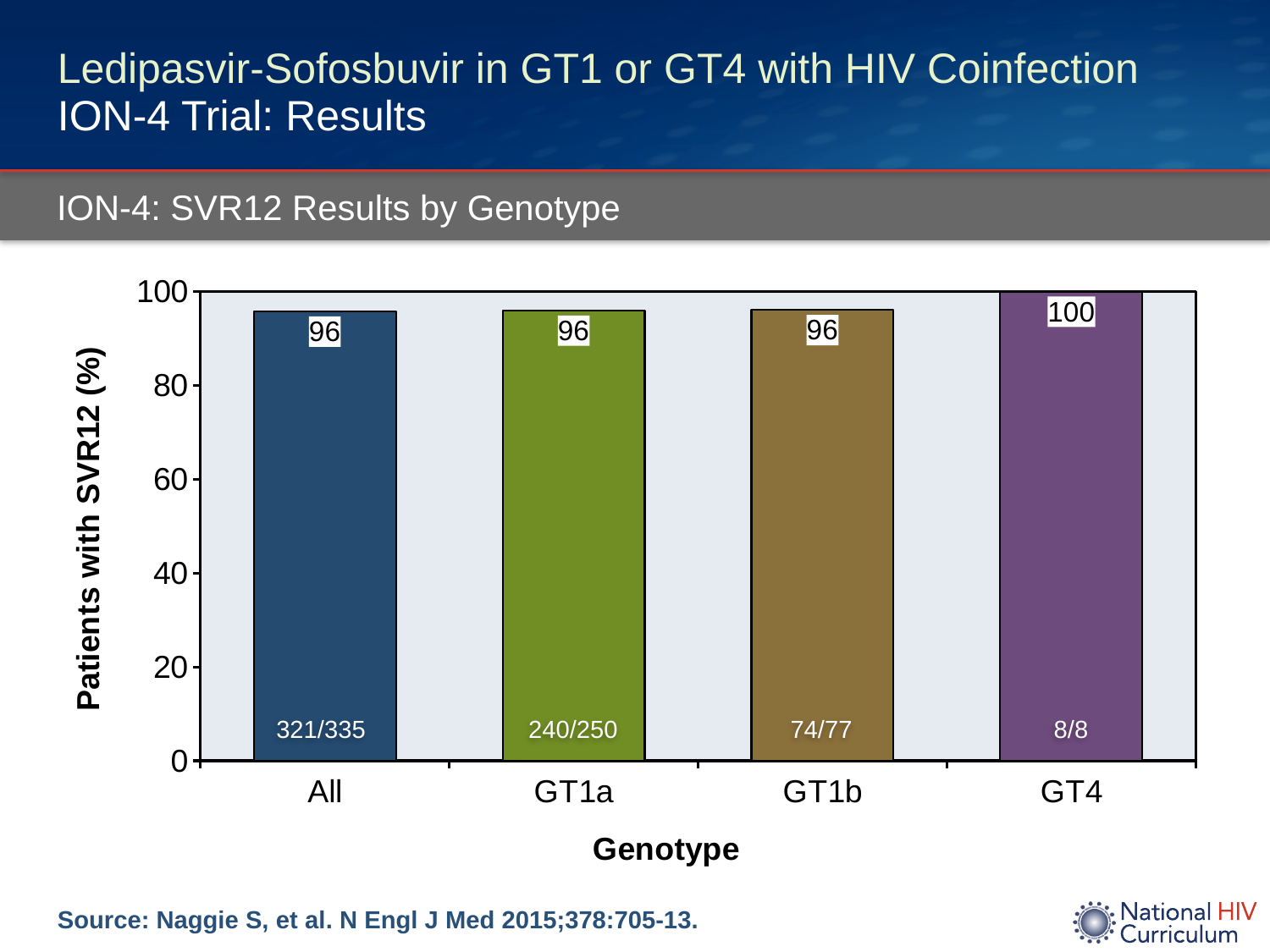
Is the SVR12 rate for GT1a greater or less than 80? greater What fraction of patients achieved SVR12 in the All group? 321/335 What type of chart is shown on the slide? Bar chart What is the SVR12 rate (%) for the GT1a group? 96 Which genotype group has the highest SVR12 rate? GT4 What is the label of the y axis? Patients with SVR12 (%) How many genotype categories are shown on the x axis? 4 What fraction of patients achieved SVR12 in the GT1b group? 74/77 What is the SVR12 rate (%) for the All group? 96 What is the difference in SVR12 rate (%) between GT4 and GT1b? 4 What is the title of the chart? ION-4: SVR12 Results by Genotype What is the SVR12 rate (%) for the GT4 group? 100